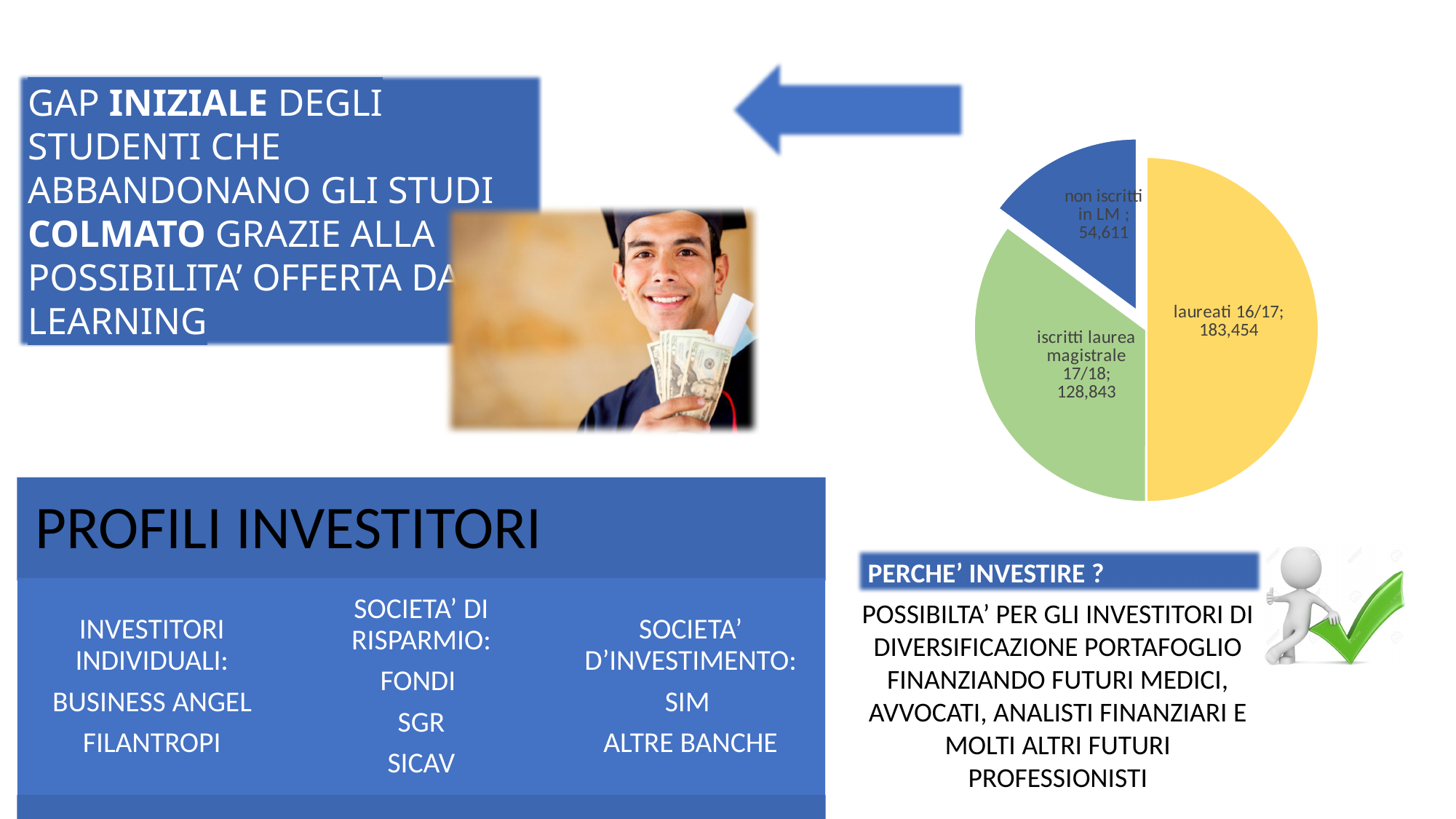
What is the value for 'non iscritti in LM' in the pie chart? 54,611 What is the difference between the values for 'iscritti laurea magistrale 17/18' and 'non iscritti in LM'? 74,232 Which category has the smallest slice in the pie chart? non iscritti in LM What is the total of all three slices in the pie chart? 366,908 Which is larger: 'iscritti laurea magistrale 17/18' or 'non iscritti in LM'? iscritti laurea magistrale 17/18 What is the difference between the values for 'laureati 16/17' and 'iscritti laurea magistrale 17/18'? 54,611 How many slices does the pie chart have? 3 What share of the pie does 'laureati 16/17' represent? 50% What is the value for 'laureati 16/17' in the pie chart? 183,454 What type of chart is shown on the slide? pie chart What is the value for 'iscritti laurea magistrale 17/18' in the pie chart? 128,843 Which category has the largest slice in the pie chart? laureati 16/17